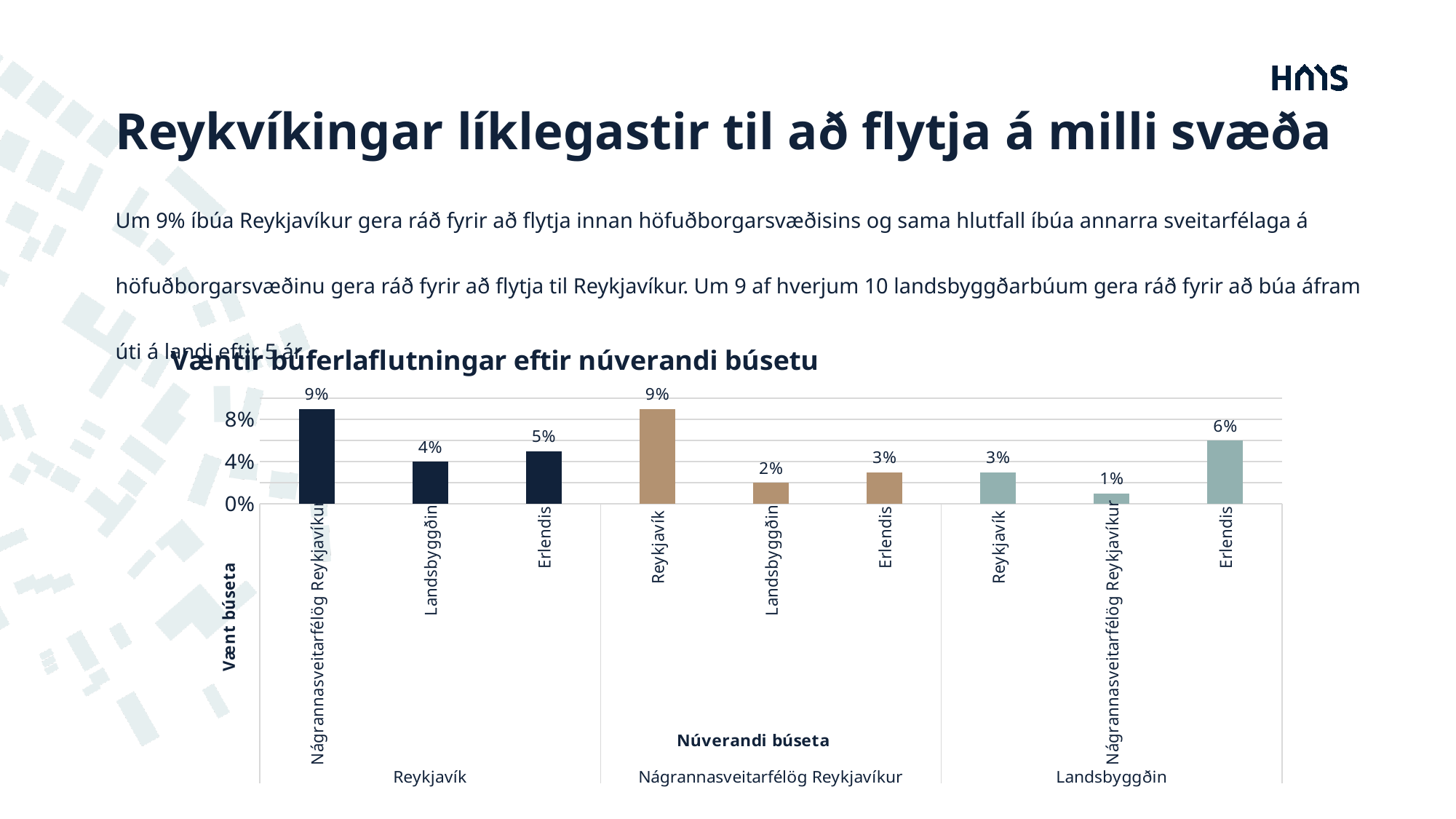
What percentage of Landsbyggðin residents expect to move to Erlendis? 6% What is the total of the three bars in the Landsbyggðin group? 10% How many current-residence groups are shown on the x axis? 3 Which is larger: the Landsbyggðin value in the Reykjavík group or the Reykjavík value in the Landsbyggðin group? Landsbyggðin value in the Reykjavík group (4%) What percentage of Nágrannasveitarfélög Reykjavíkur residents expect to move to Landsbyggðin? 2% What is the label of the horizontal axis of the chart? Núverandi búseta How many bars are plotted in the chart? 9 What is the difference between the Erlendis value in the Reykjavík group and the Erlendis value in the Nágrannasveitarfélög Reykjavíkur group? 2% Which bar in the chart has the lowest value? Nágrannasveitarfélög Reykjavíkur (in the Landsbyggðin group), 1% What is the title of the chart? Væntir búferlaflutningar eftir núverandi búsetu What percentage of Reykjavík residents expect to move to Nágrannasveitarfélög Reykjavíkur? 9% What type of chart is shown on the slide? Bar chart